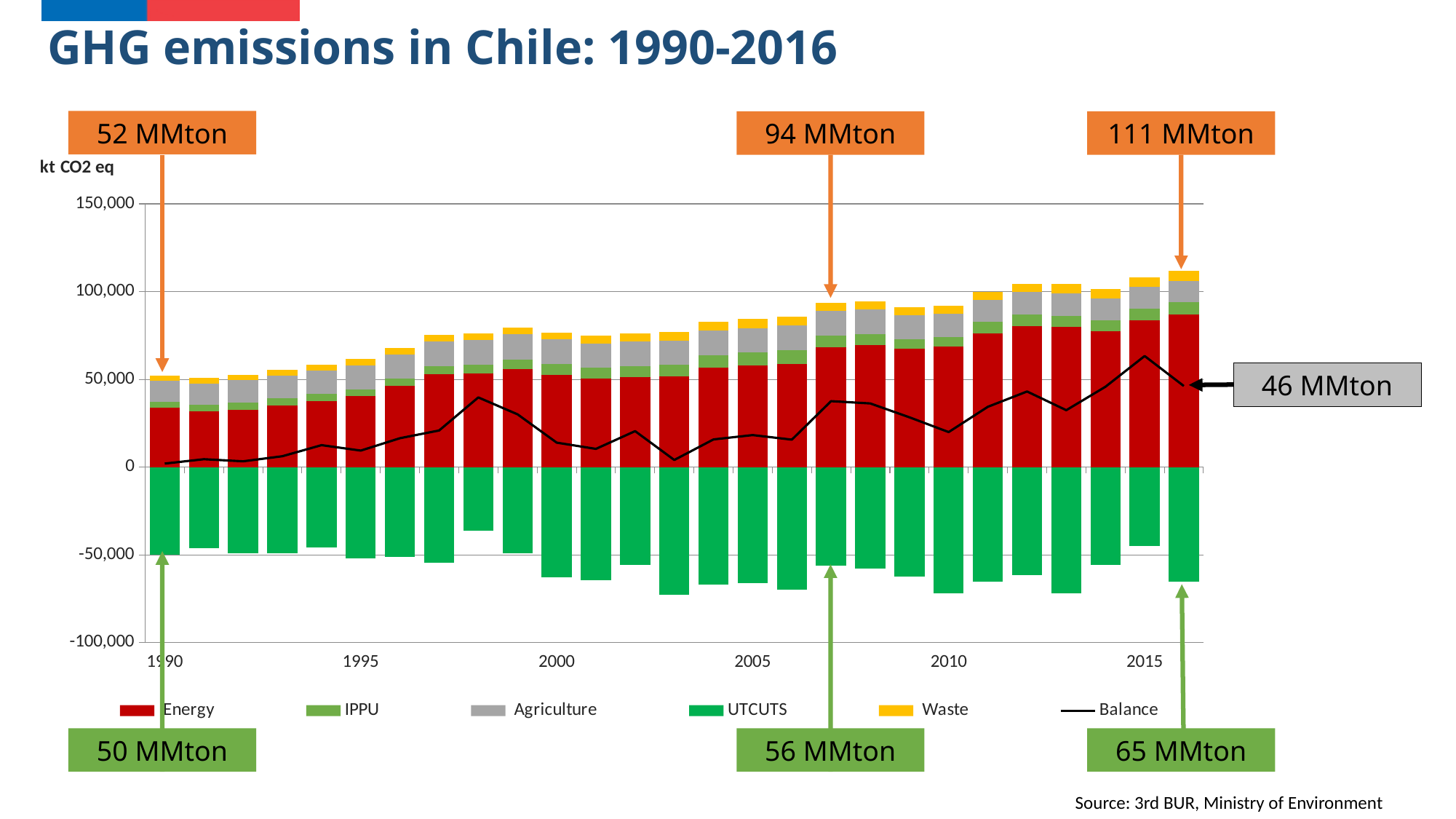
What UTCUTS value is annotated for 2016? 65 MMton What kind of chart is shown on the slide? combination bar and line chart (stacked bars with a line) Do total positive emissions generally rise or fall from 1990 to 2016? rise What unit is shown on the vertical axis? kt CO2 eq What is the difference between the annotated UTCUTS values for 2016 and 1990? 15 MMton What is the difference between the annotated total emissions for 2016 and 1990? 59 MMton What Balance value is annotated for 2016? 46 MMton What total emissions value is annotated for 1990? 52 MMton How many series does the legend list? 6 What total emissions value is annotated for 2016? 111 MMton Is the Energy value for 2016 greater or less than 50,000? greater What total emissions value is annotated for 2007? 94 MMton